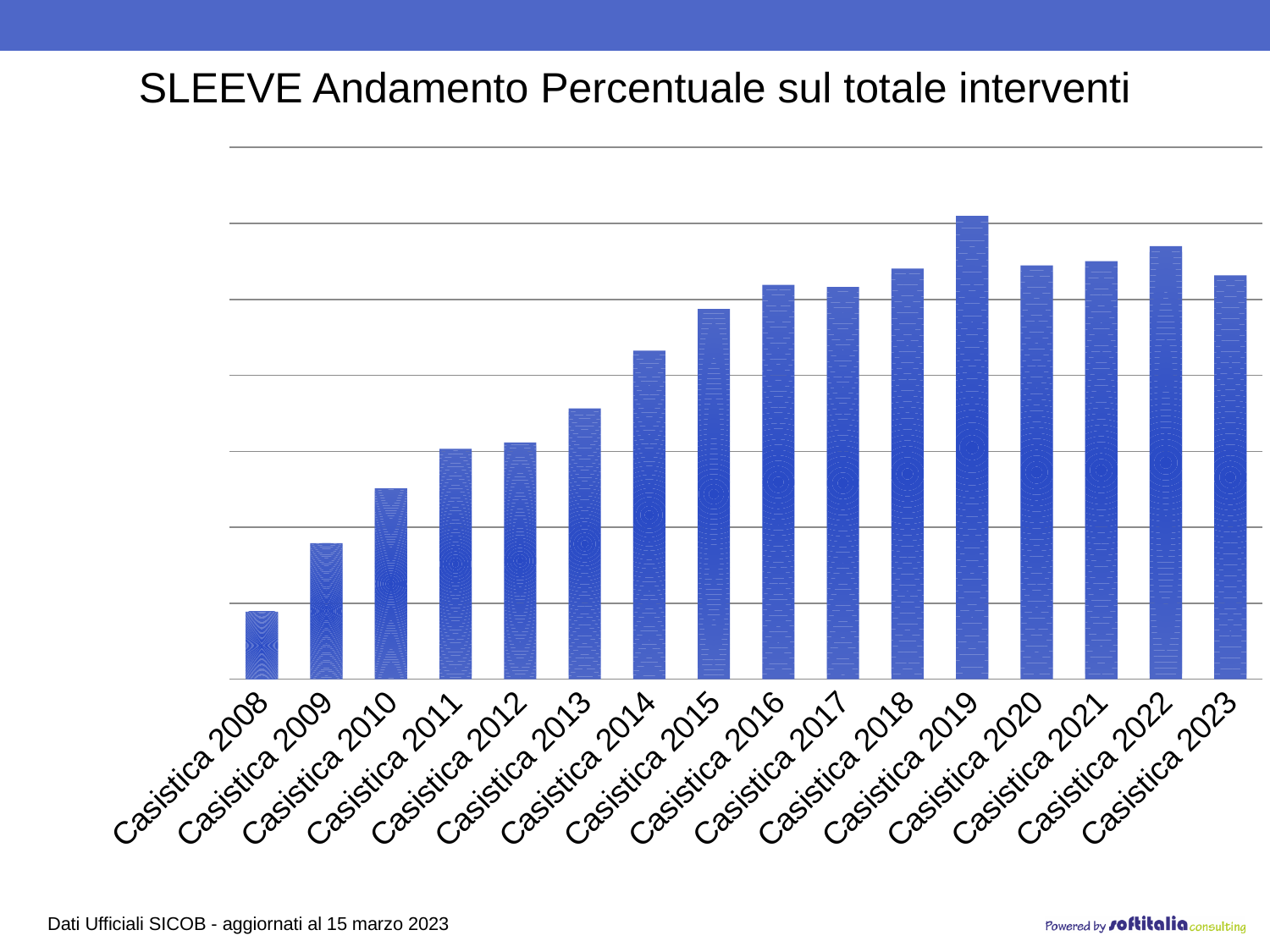
Which category has the highest bar? Casistica 2019 Which is larger, the value for Casistica 2022 or Casistica 2023? Casistica 2022 Which is larger, the value for Casistica 2009 or Casistica 2010? Casistica 2010 Which category has the lowest bar? Casistica 2008 What kind of chart is shown on the slide? Bar chart How many categories (bars) are plotted in the chart? 16 Which is larger, the value for Casistica 2019 or Casistica 2020? Casistica 2019 Which is the first category on the x axis? Casistica 2008 What is the title of the chart? SLEEVE Andamento Percentuale sul totale interventi Do the values rise or fall from Casistica 2008 to Casistica 2019? Rise